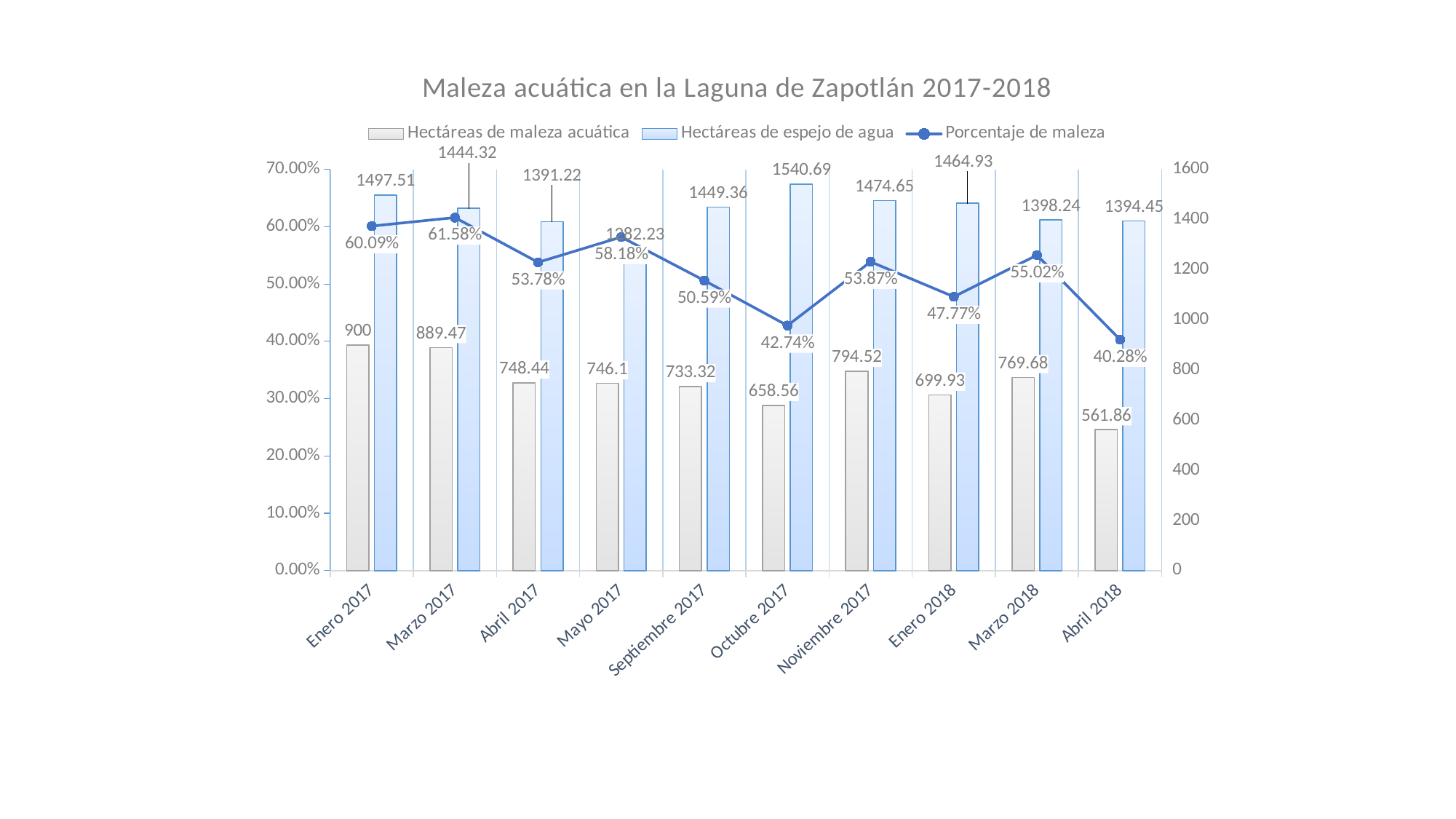
What is the Porcentaje de maleza for Octubre 2017? 42.74% What is the difference in Hectáreas de maleza acuática between Enero 2017 and Abril 2018? 338.14 Which month has the highest value of Hectáreas de espejo de agua? Octubre 2017 What is the value of Hectáreas de maleza acuática for Enero 2017? 900 What kind of chart is shown on the slide? Combined bar and line chart What is the value of Hectáreas de espejo de agua for Octubre 2017? 1540.69 Which month has the lowest value of Hectáreas de maleza acuática? Abril 2018 How many series does the legend list? 3 How many months are shown on the x axis? 10 Which month has the highest Porcentaje de maleza? Marzo 2017 Which has a larger value of Hectáreas de maleza acuática, Noviembre 2017 or Marzo 2018? Noviembre 2017 What is the Porcentaje de maleza for Abril 2018? 40.28%